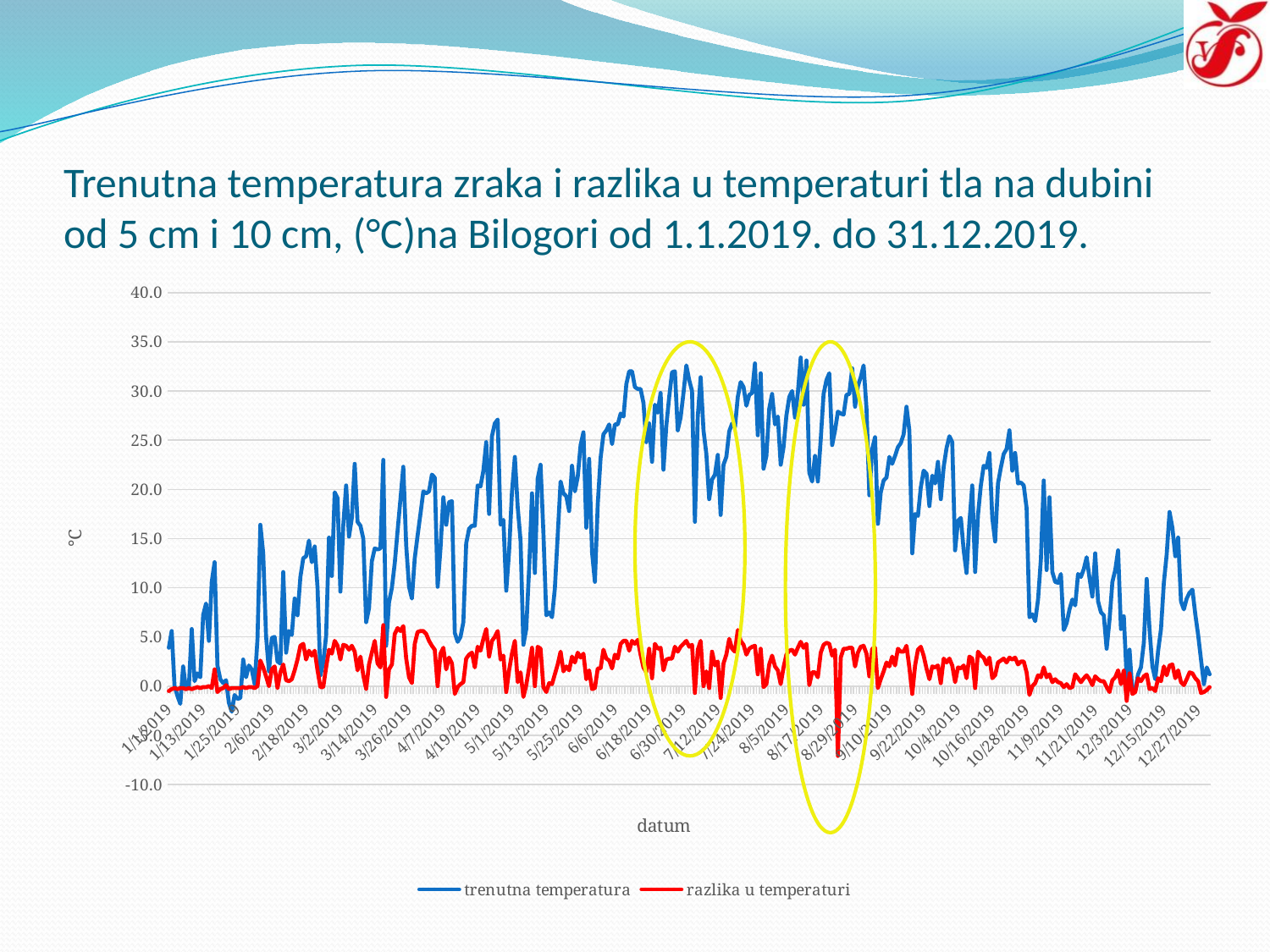
What is the label of the x axis? datum Is the highest value of the trenutna temperatura series greater or less than 35.0? less What kind of chart is shown on the slide? line chart Is the highest value of the razlika u temperaturi series greater or less than 10.0? less What are the two series named in the legend? trenutna temperatura, razlika u temperaturi Around 7/12/2019, which series has the higher value, trenutna temperatura or razlika u temperaturi? trenutna temperatura Is the value of trenutna temperatura at 1/1/2019 greater or less than 10.0? less How many series does the legend list? 2 Does the trenutna temperatura series generally rise or fall from 8/29/2019 to 12/27/2019? fall Does the trenutna temperatura series generally rise or fall from 1/1/2019 to 7/12/2019? rise